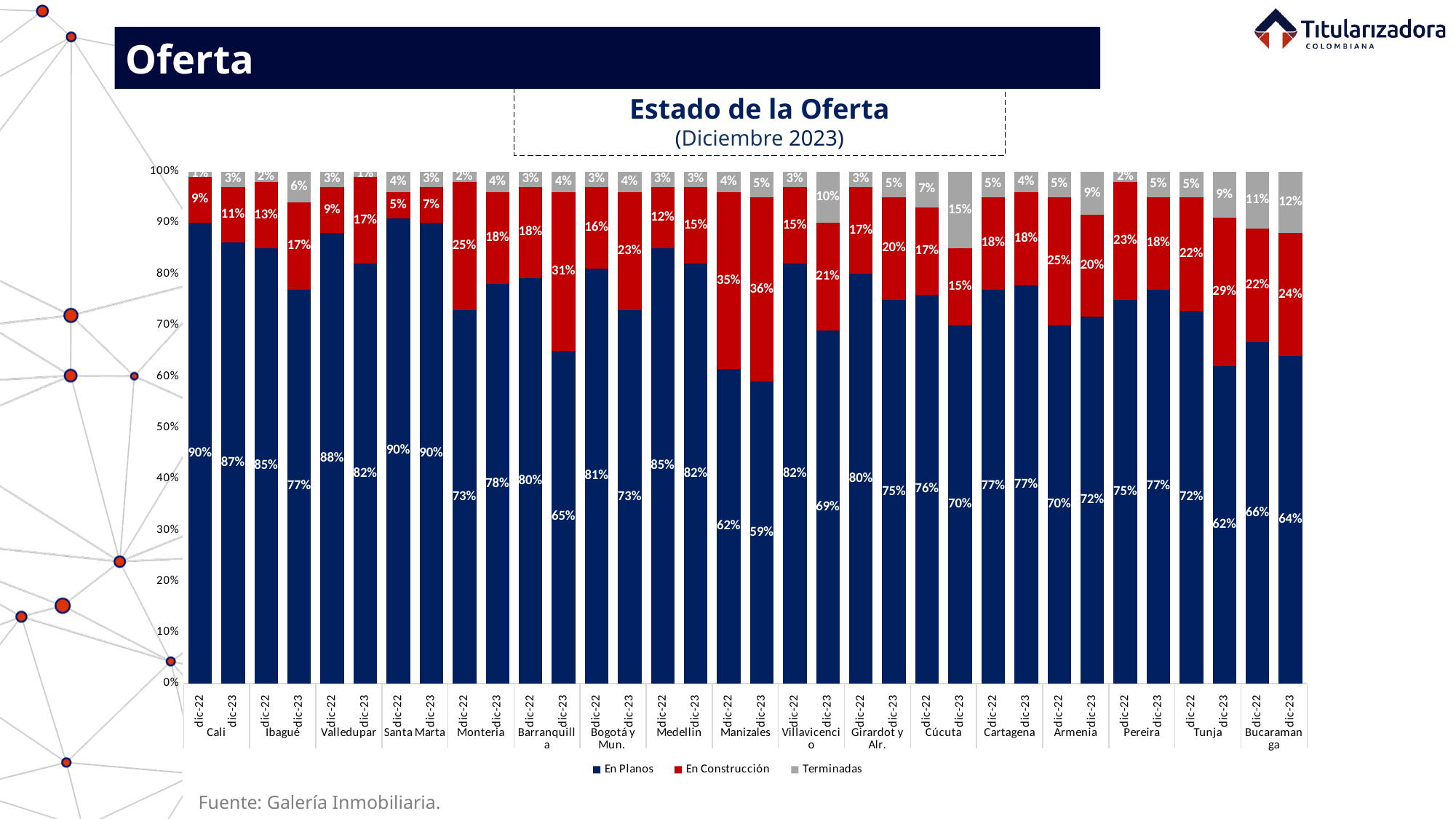
Which bar has the lowest En Planos share? Manizales dic-23 How many cities are shown on the x axis? 17 Did the En Planos share for Villavicencio rise or fall from dic-22 to dic-23? Fall What is the difference between the En Planos share for Cali in dic-22 and in dic-23? 3% Which bar has the highest En Construcción share? Manizales dic-23 What is the title of the chart? Estado de la Oferta (Diciembre 2023) What is the Terminadas share for Cúcuta in dic-23? 15% What is the En Construcción share for Barranquilla in dic-23? 31% Which is larger, the En Planos share for Tunja in dic-23 or for Bucaramanga in dic-23? Bucaramanga dic-23 What kind of chart is shown on the slide? Stacked bar chart What is the En Planos share for Manizales in dic-23? 59% How many series does the legend list? 3